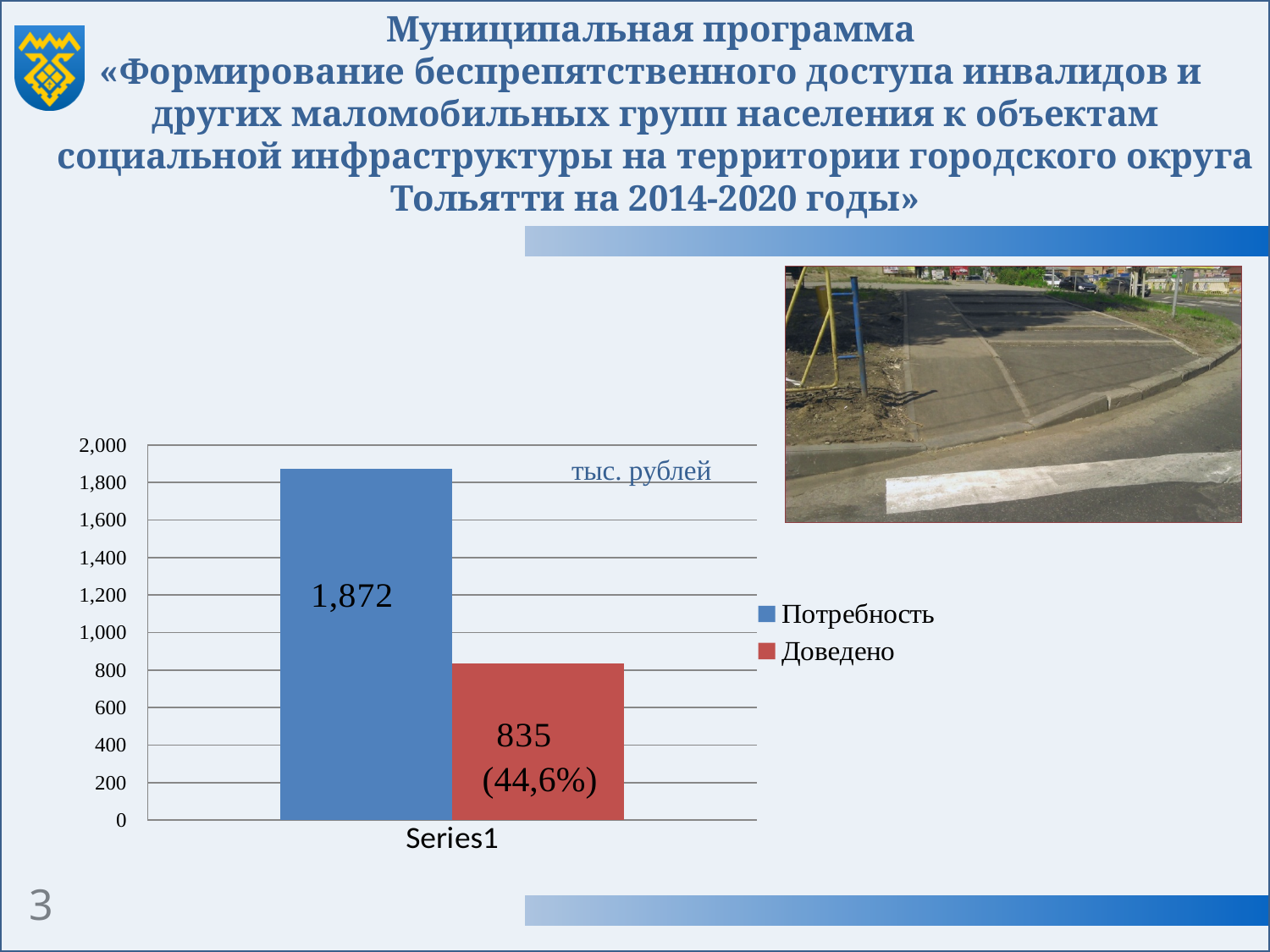
What colour is the bar for Доведено? red What kind of chart is shown on the slide? bar chart What unit label is shown on the chart? тыс. рублей Which series has the higher value, Потребность or Доведено? Потребность What is the value for Потребность? 1,872 What is the category label shown on the x axis? Series1 Is the value for Потребность greater or less than 1,800? greater What percentage is shown in the data label for Доведено? 44,6% What is the difference between the Потребность and Доведено values? 1,037 What is the value for Доведено? 835 How many series does the legend list? 2 Is the value for Доведено greater or less than 1,000? less